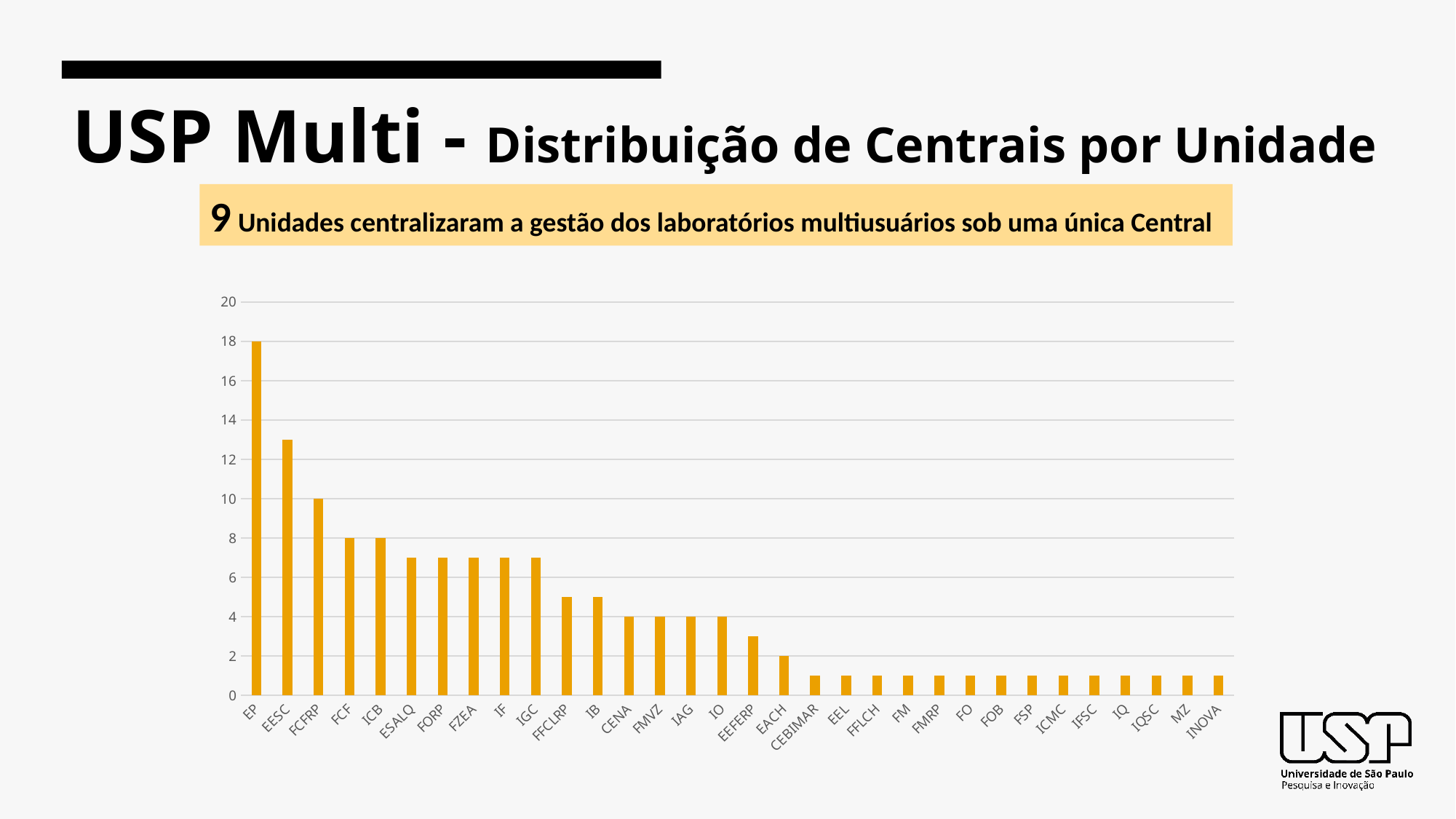
Is the value for EESC greater or less than 12? greater What is the value for FCF? 8 Which is larger, the value for ICB or the value for IB? ICB What is the value for EACH? 2 Which unit has the highest number of centrais? EP What is the value for FCFRP? 10 How many units are shown on the x axis? 32 What kind of chart is shown on the slide? bar chart What is the value for EP? 18 Do the values rise or fall from left to right along the x axis? fall Is the value for FFCLRP greater or less than 6? less What is the difference between the values for EP and FCFRP? 8